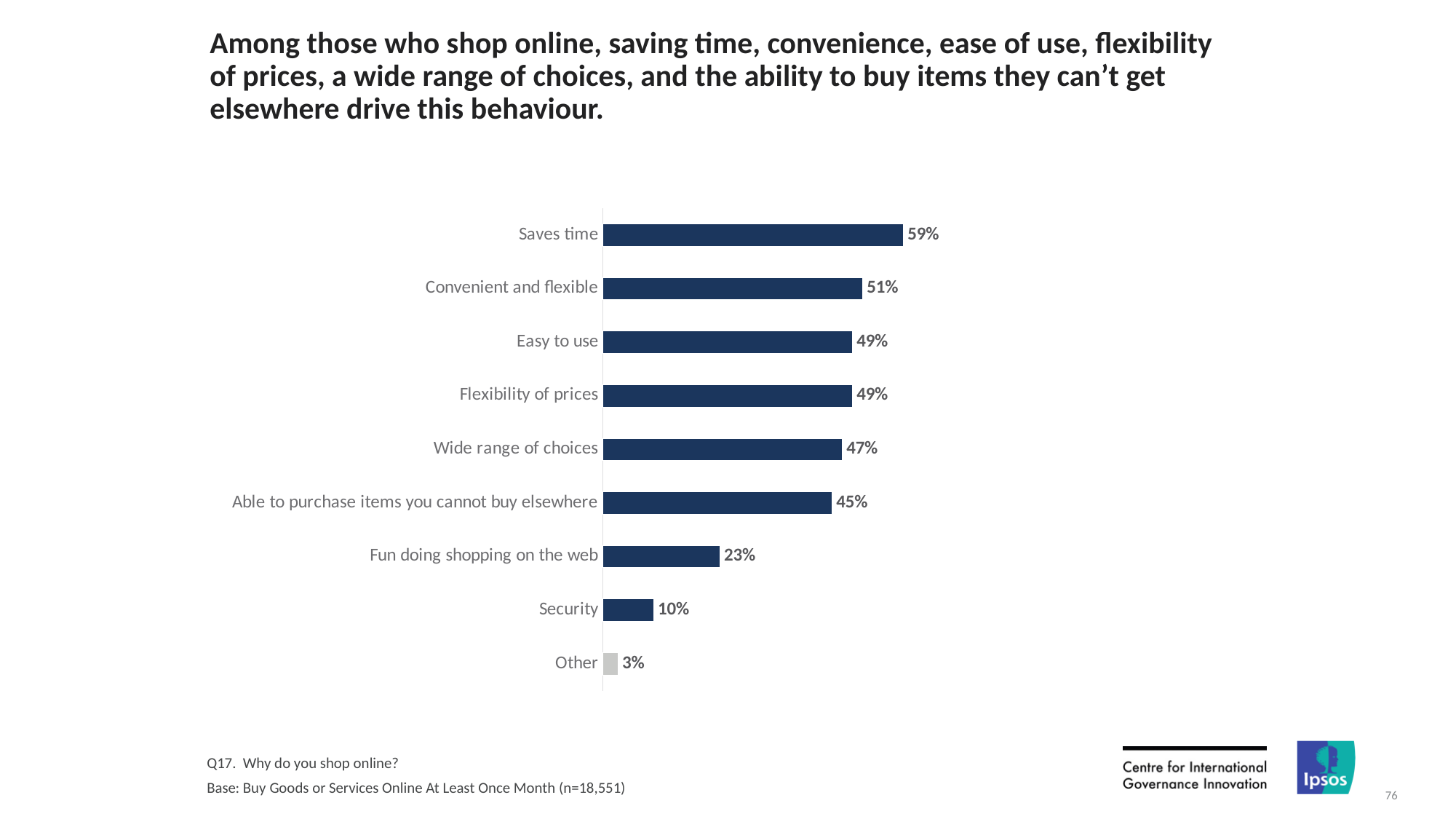
Which reason for shopping online has the highest percentage? Saves time What is the value for 'Security'? 10% How many categories are shown in the chart? 9 What is the difference between 'Saves time' and 'Convenient and flexible'? 8% What is the value for 'Fun doing shopping on the web'? 23% What kind of chart is shown on the slide? Bar chart What is the value for 'Able to purchase items you cannot buy elsewhere'? 45% What is the difference between 'Fun doing shopping on the web' and 'Security'? 13% Which category has the lowest percentage? Other Which is larger: 'Wide range of choices' or 'Able to purchase items you cannot buy elsewhere'? Wide range of choices What percentage of online shoppers say they shop online because it saves time? 59% Which two categories share the same value of 49%? Easy to use and Flexibility of prices